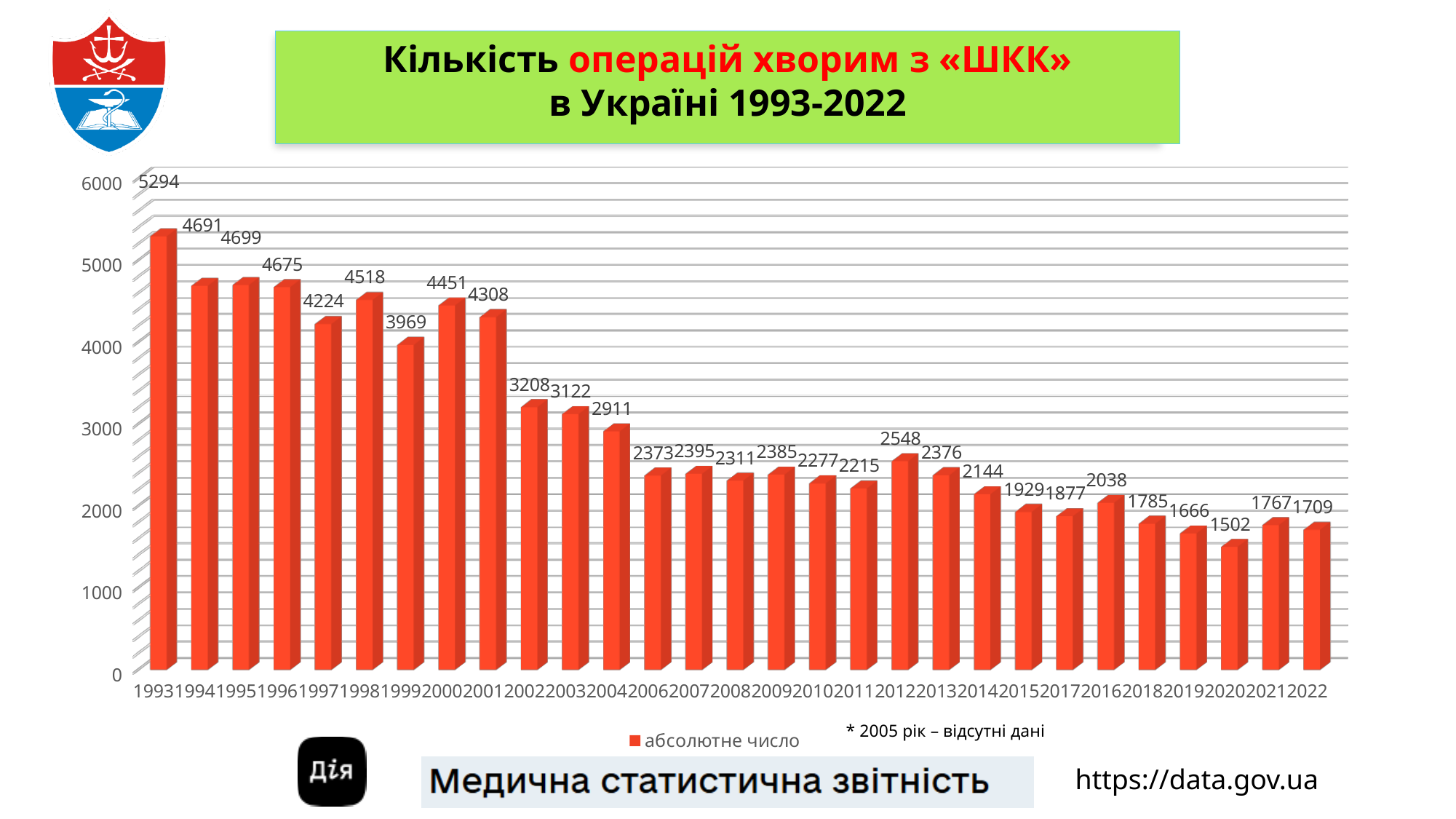
Which year has the highest value? 1993 Which year is noted as having no data, according to the footnote? 2005 What is the difference between the values for 1993 and 2022? 3585 Which year has the lowest value? 2020 What is the value for 2020? 1502 How many years (bars) are shown on the chart? 29 How many series does the legend list? 1 What type of chart is shown on the slide? bar chart What is the value for 1993? 5294 Which is larger, the value for 2002 or the value for 2004? 2002 What is the value for 2012? 2548 Do the values generally rise or fall from 1993 to 2022? fall